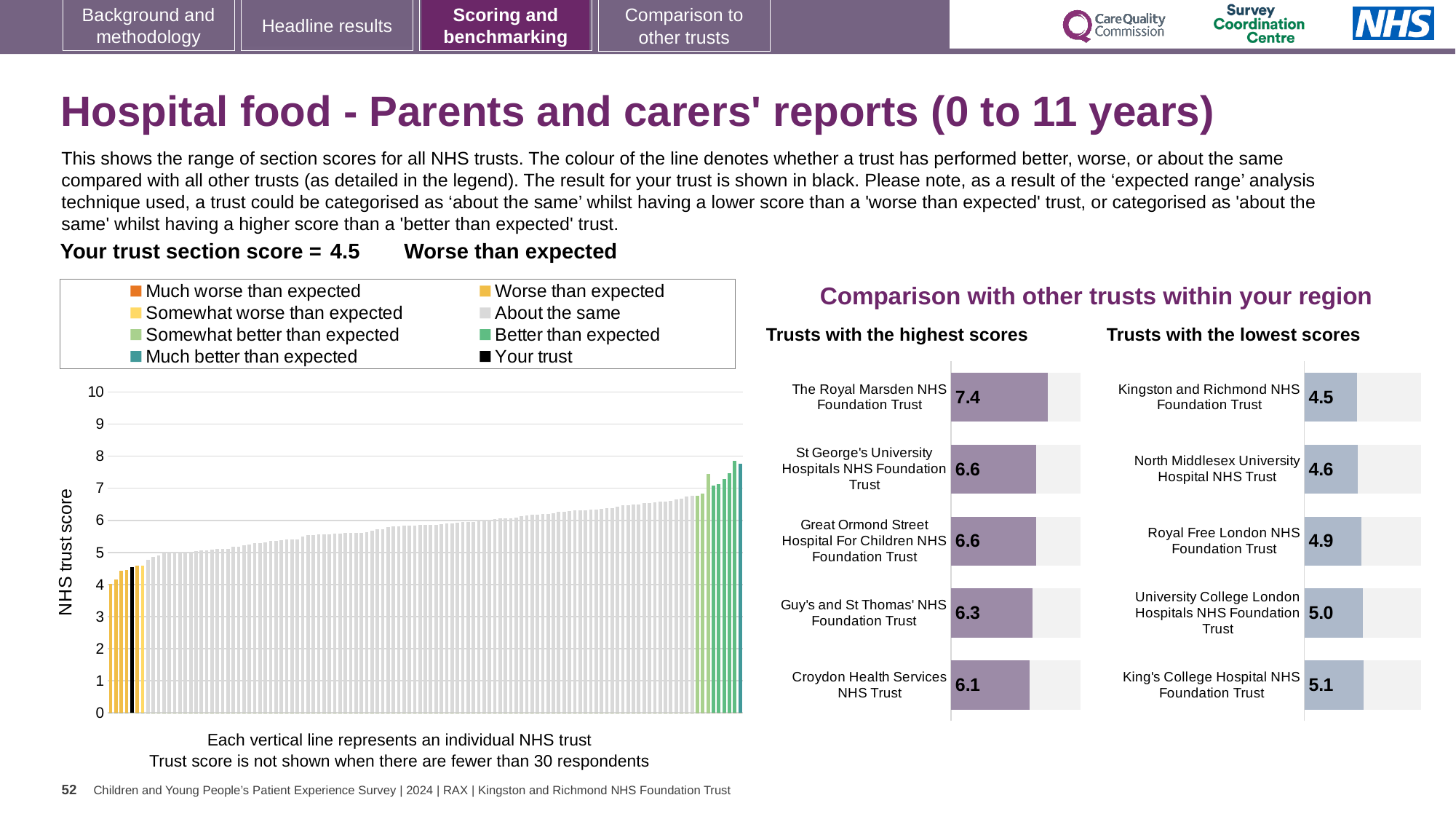
How many trusts are shown in the 'Trusts with the lowest scores' chart? 5 In the large chart on the left, is the value of the tallest bar greater or less than 7? greater In the 'Trusts with the highest scores' chart, which trust has the highest score? The Royal Marsden NHS Foundation Trust In the large chart on the left, do the NHS trust scores rise or fall from left to right? Rise In the 'Trusts with the lowest scores' chart, which trust has the lowest score? Kingston and Richmond NHS Foundation Trust In the 'Trusts with the lowest scores' chart, what is the score for Royal Free London NHS Foundation Trust? 4.9 In the 'Trusts with the highest scores' chart, which has the higher score: Guy's and St Thomas' NHS Foundation Trust or Croydon Health Services NHS Trust? Guy's and St Thomas' NHS Foundation Trust In the 'Trusts with the highest scores' chart, what is the difference between the scores of The Royal Marsden NHS Foundation Trust and Croydon Health Services NHS Trust? 1.3 In the 'Trusts with the highest scores' chart, what is the score for The Royal Marsden NHS Foundation Trust? 7.4 In the 'Trusts with the lowest scores' chart, what is the difference between the scores of King's College Hospital NHS Foundation Trust and Kingston and Richmond NHS Foundation Trust? 0.6 In the 'Trusts with the highest scores' chart, what is the score for Croydon Health Services NHS Trust? 6.1 What kind of chart is the large chart on the left showing NHS trust scores? Bar chart